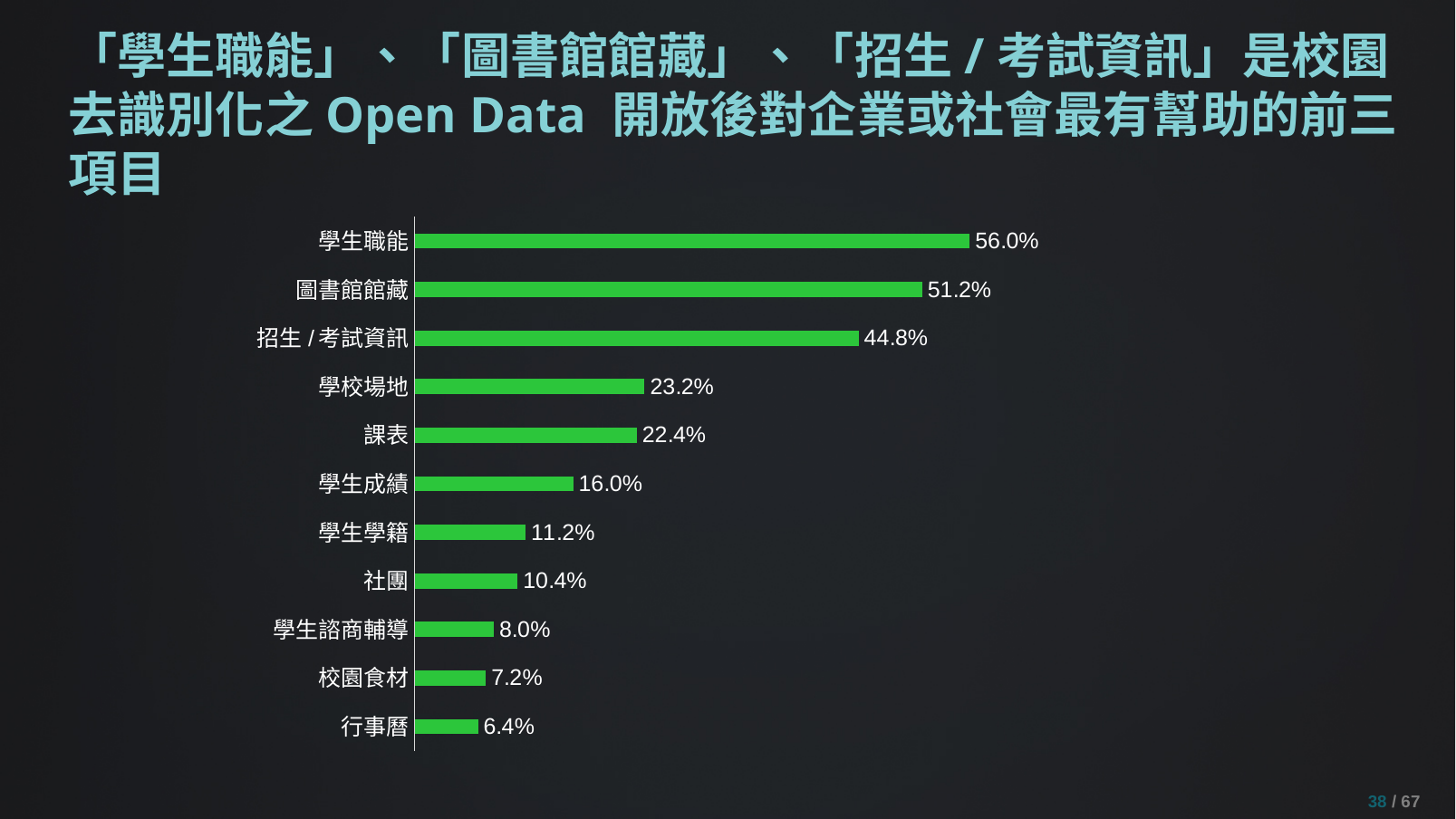
What is the difference between the values for 學生成績 and 學生學籍? 4.8% Which category has the lowest value? 行事曆 Which is larger, the value for 學校場地 or the value for 課表? 學校場地 What colour are the bars in the chart? Green What is the value for 課表? 22.4% What is the difference between the values for 學生職能 and 圖書館館藏? 4.8% What is the value for 校園食材? 7.2% How many categories are shown in the chart? 11 Which is larger, the value for 社團 or the value for 學生諮商輔導? 社團 What is the value for 學生職能? 56.0% What kind of chart is shown on the slide? Bar chart Which category has the highest value? 學生職能